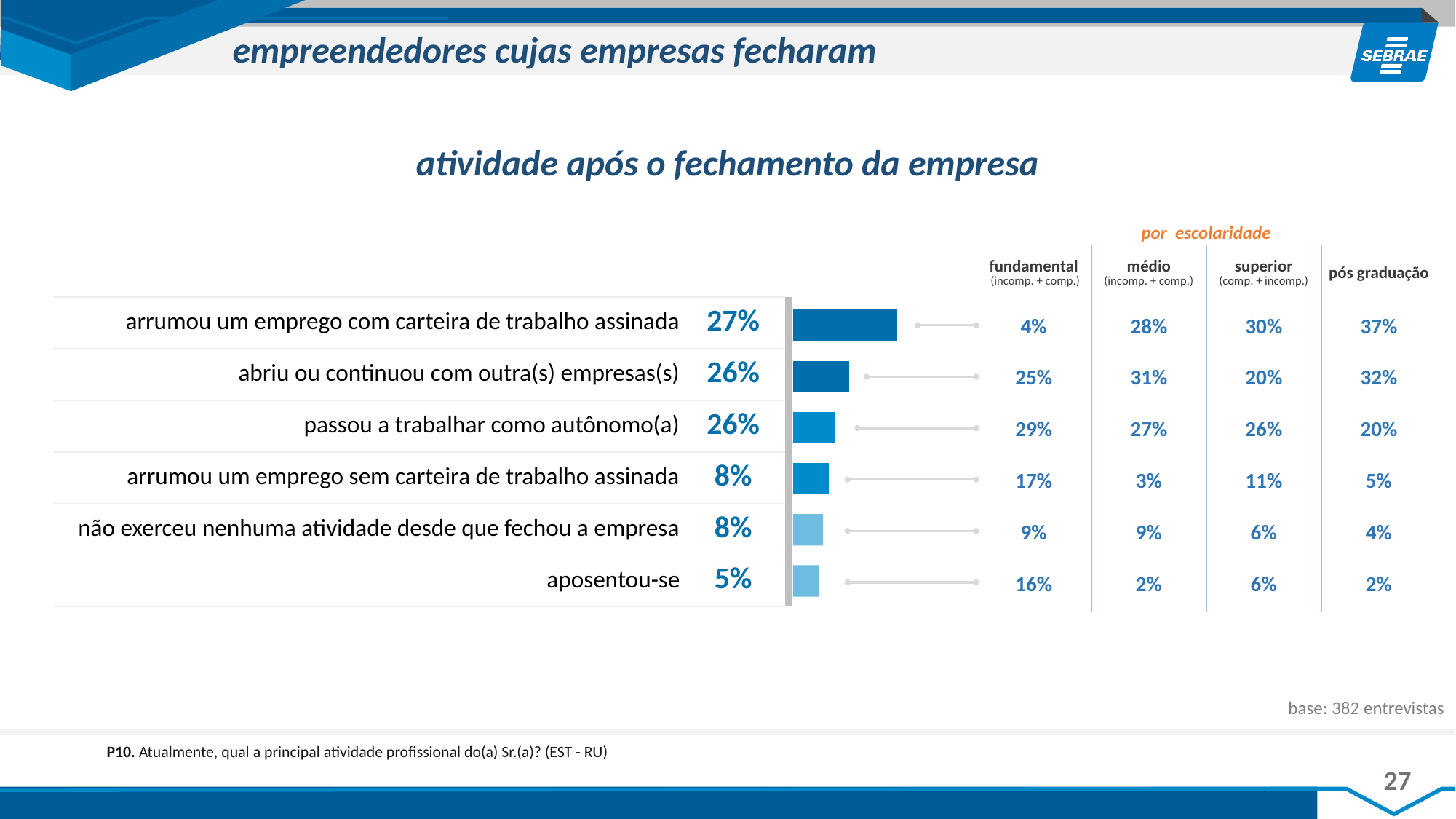
In the "por escolaridade" table, what is the value for "aposentou-se" in the "fundamental" column? 16% What is the value for "aposentou-se"? 5% What is the value for "arrumou um emprego com carteira de trabalho assinada"? 27% Which is larger: the value for "abriu ou continuou com outra(s) empresas(s)" or for "arrumou um emprego sem carteira de trabalho assinada"? abriu ou continuou com outra(s) empresas(s) What is the value for "passou a trabalhar como autônomo(a)"? 26% What is the difference between the values for "arrumou um emprego com carteira de trabalho assinada" and "aposentou-se"? 22% What is the title of the chart on the slide? atividade após o fechamento da empresa What kind of chart is shown on the slide? bar chart How many categories does the bar chart show? 6 Which category has the highest value in the bar chart? arrumou um emprego com carteira de trabalho assinada Which category has the lowest value in the bar chart? aposentou-se In the "por escolaridade" table, what is the value for "arrumou um emprego com carteira de trabalho assinada" in the "pós graduação" column? 37%